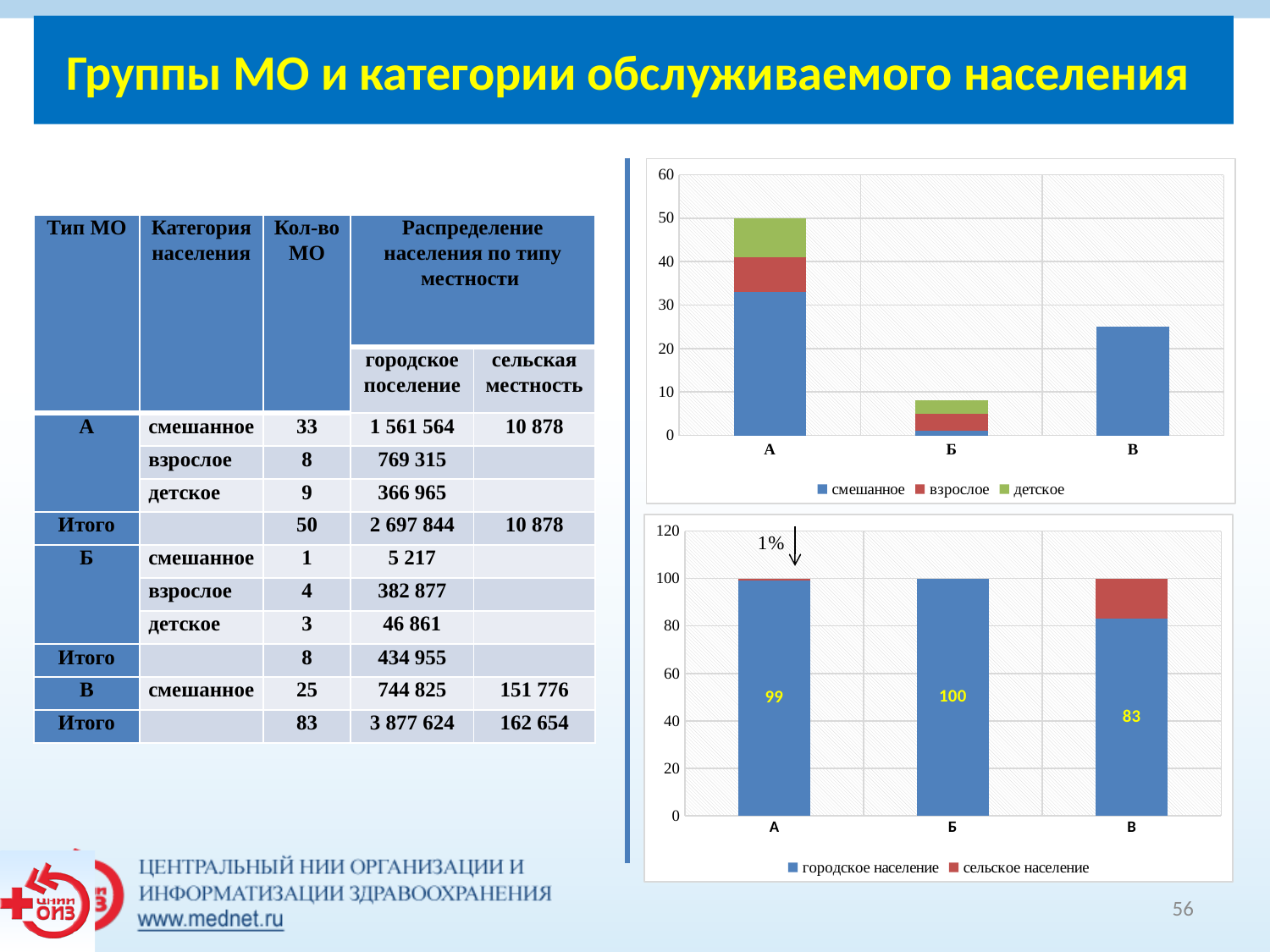
In the bottom chart, which category has the lowest value for городское население? В In the bottom chart, what are the two legend entries? городское население, сельское население In the bottom chart, what is the difference between the городское население values for Б and В? 17 In the bottom chart, what is the value of городское население for А? 99 In the top chart, is the смешанное value for В greater or less than 20? greater In the top chart, how many series does the legend list? 3 In the top chart, is the total height of the bar for Б greater or less than 10? less In the top chart, which stacked bar is taller, Б or В? В In the top chart, which category has the tallest stacked bar? А In the top chart, how many categories are shown on the x axis? 3 What kind of chart is the top chart on the right of the slide? stacked bar chart In the bottom chart, what is the value of городское население for В? 83